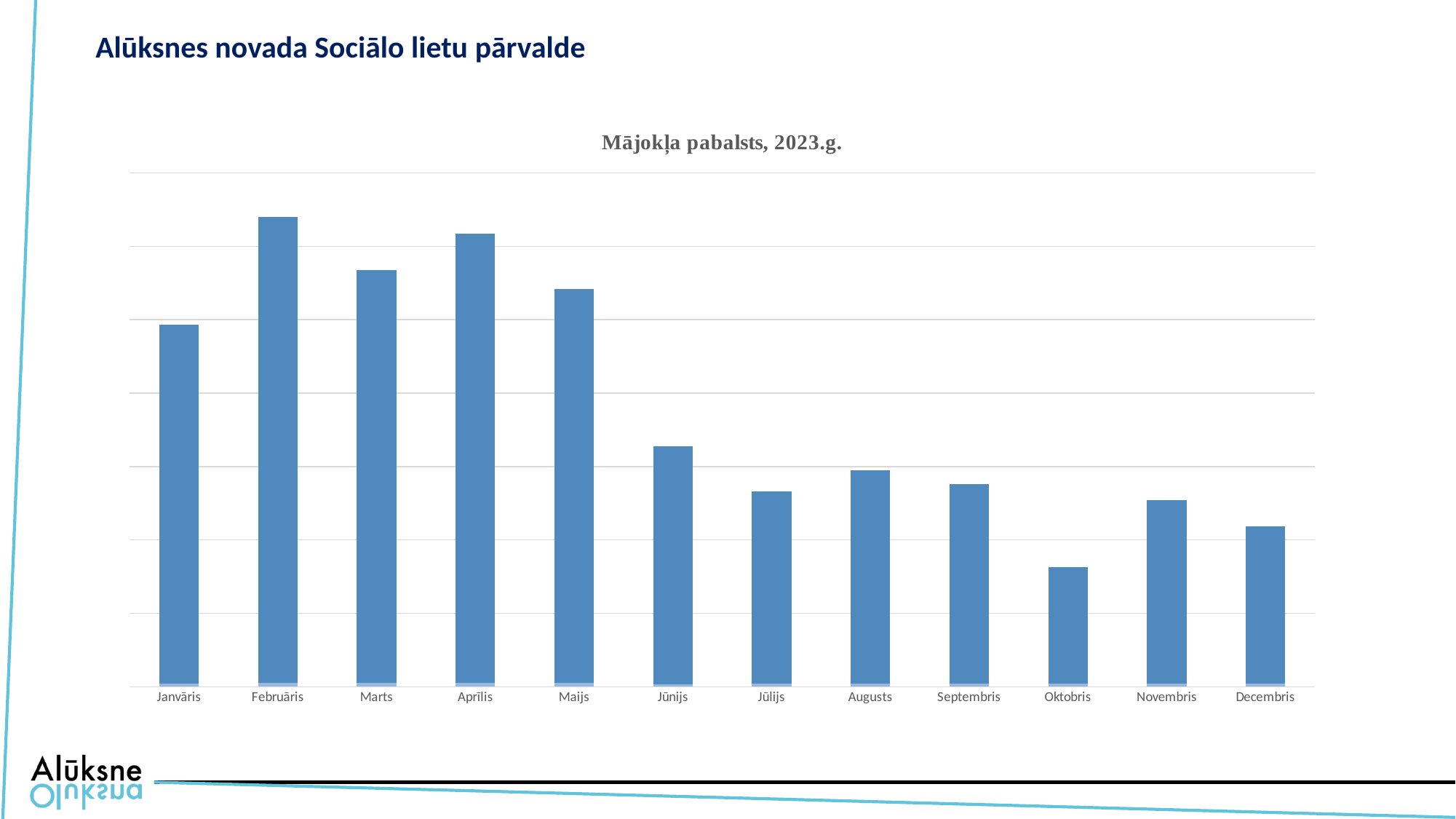
What kind of chart is shown on the slide? bar chart Which has the larger value, Oktobris or Septembris? Septembris Which has the larger value, Jūnijs or Jūlijs? Jūnijs Which has the larger value, Marts or Aprīlis? Aprīlis What is the title of the chart? Mājokļa pabalsts, 2023.g. What colour are the bars in the chart? blue Do the values rise or fall from Maijs to Jūnijs? fall How many months (categories) are shown on the x axis of the chart? 12 Which month has the highest value in the chart? Februāris Which month has the lowest value in the chart? Oktobris